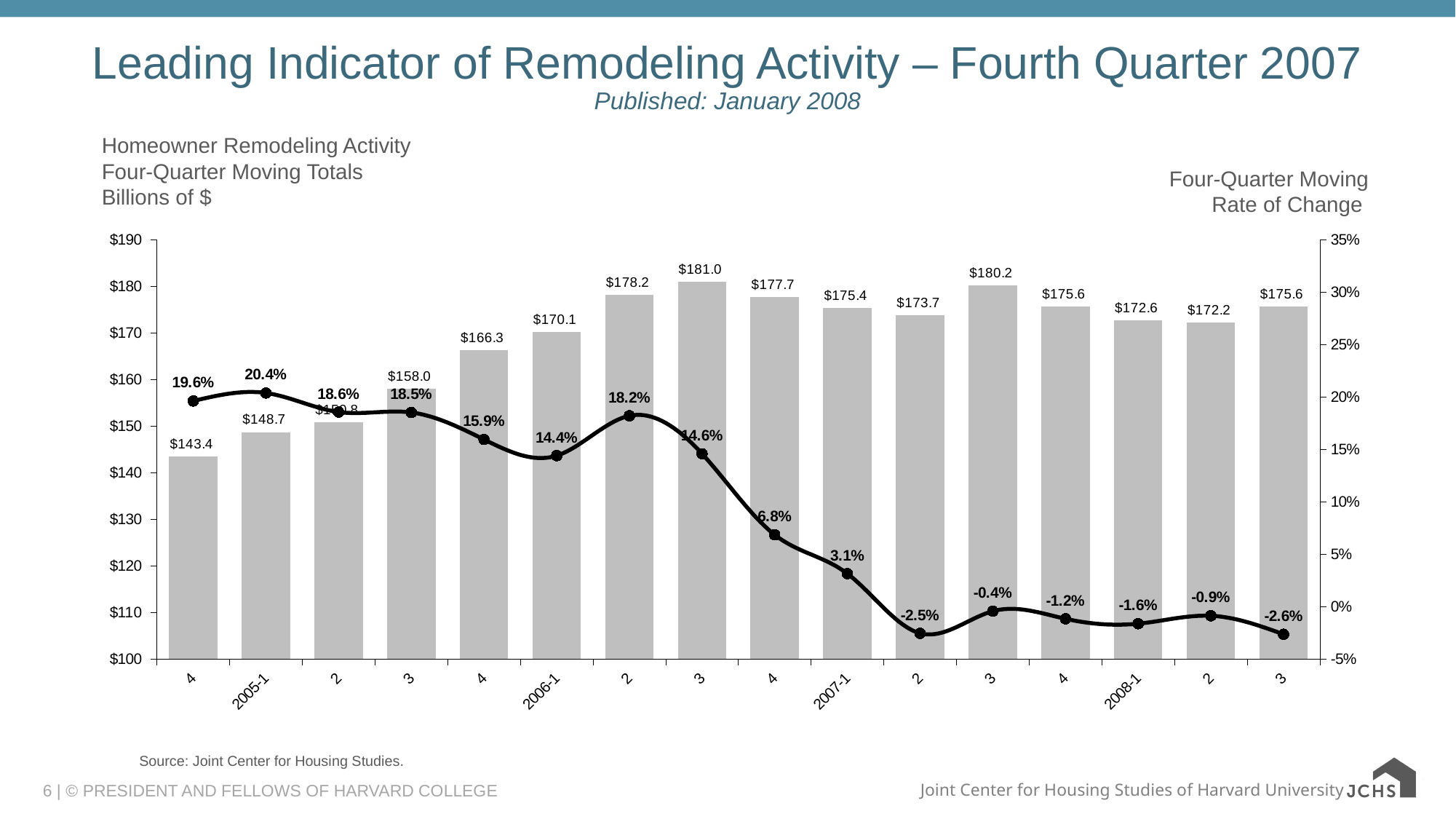
Which quarter has the lowest four-quarter moving rate of change? 2008-3 (-2.6%) Which quarter has the highest four-quarter moving rate of change? 2005-1 (20.4%) Is the four-quarter moving total for 2005-3 greater or less than $150? greater Which is larger, the four-quarter moving total for 2007-3 or for 2008-1? 2007-3 ($180.2) What is the four-quarter moving rate of change for 2007-1? 3.1% What kind of chart is this? Combined bar and line chart What unit is used for the left axis of the chart? Billions of $ What is the difference between the four-quarter moving totals for 2006-3 and 2007-1? $5.6 Does the four-quarter moving rate of change rise or fall from 2006-2 to 2007-2? Fall How many quarters are plotted on the chart? 16 Which quarter has the highest four-quarter moving total? 2006-3 ($181.0) What is the four-quarter moving total for 2006-1? $170.1